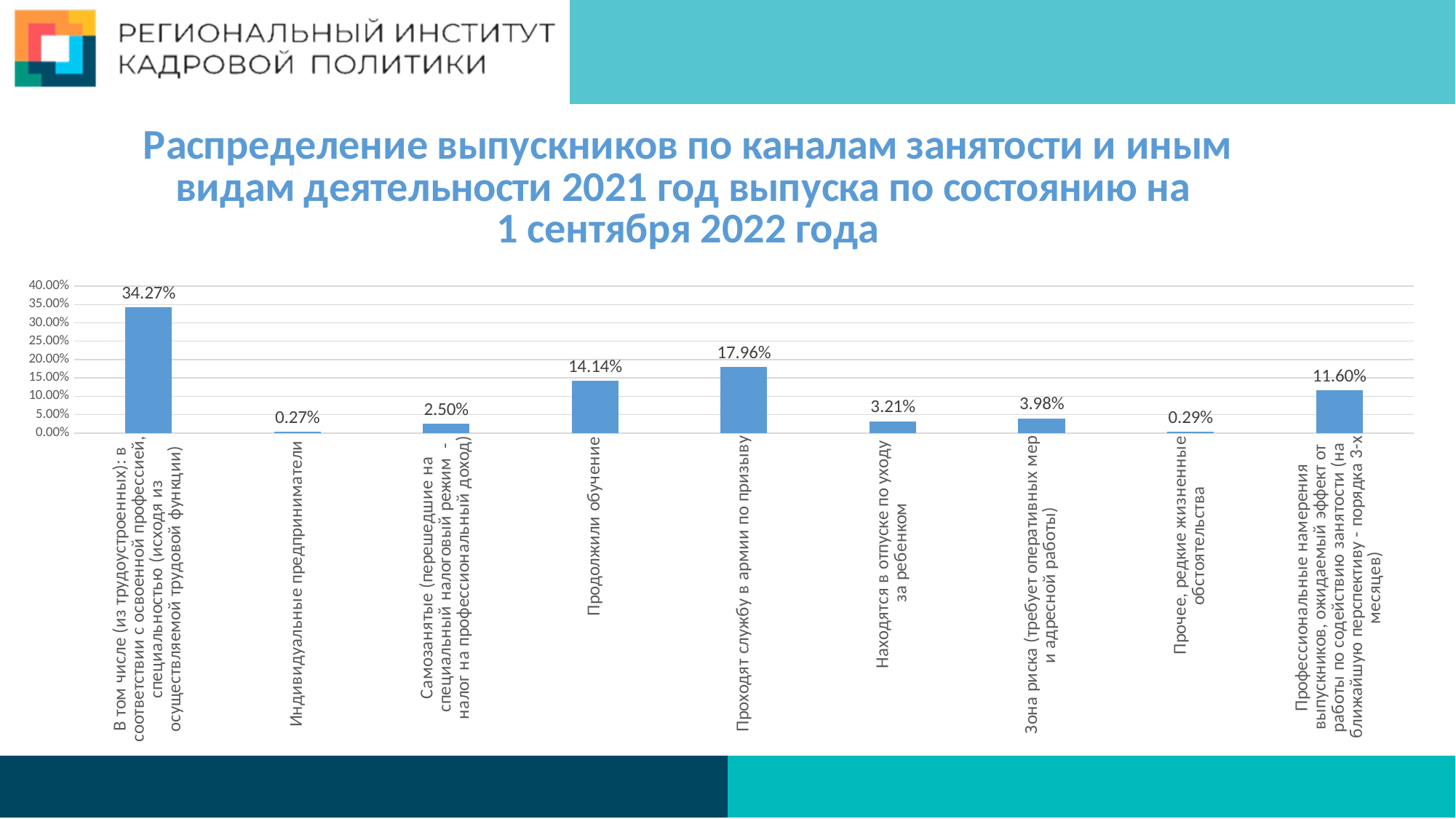
What is the value for "Находятся в отпуске по уходу за ребенком"? 3.21% What type of chart is shown on the slide? bar chart Is the value for "Профессиональные намерения выпускников" greater or less than 10.00%? greater What is the value for "Зона риска (требует оперативных мер и адресной работы)"? 3.98% What is the difference between the values for "Проходят службу в армии по призыву" and "Продолжили обучение"? 3.82% What is the highest value shown on the vertical axis? 40.00% What is the value for "Индивидуальные предприниматели"? 0.27% How many categories are plotted in the chart? 9 What is the value for "Проходят службу в армии по призыву"? 17.96% Which is larger: the value for "Самозанятые" or the value for "Находятся в отпуске по уходу за ребенком"? Находятся в отпуске по уходу за ребенком What is the value for "Продолжили обучение"? 14.14% Which category has the highest value? В том числе (из трудоустроенных): в соответствии с освоенной профессией, специальностью (исходя из осуществляемой трудовой функции)